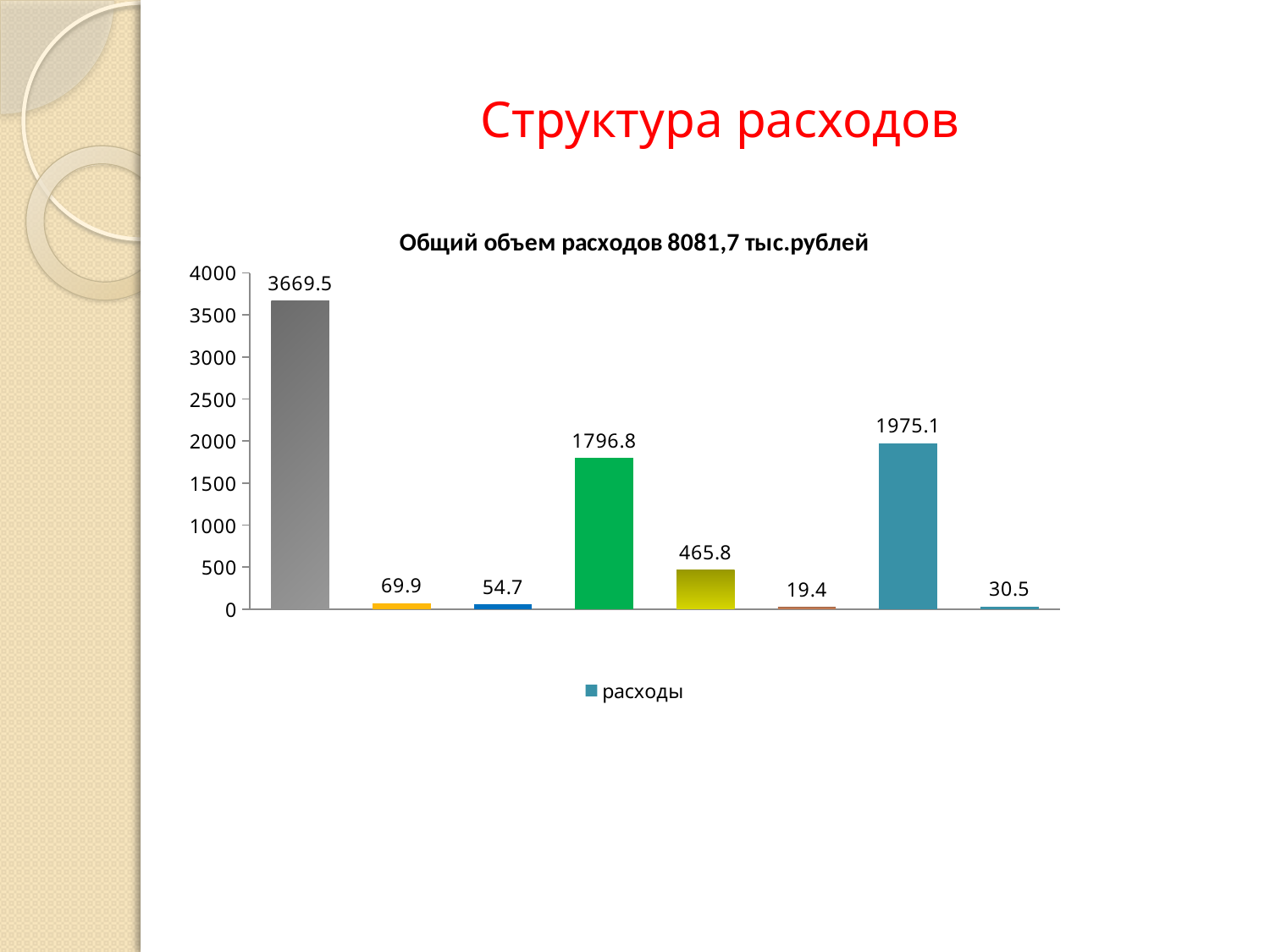
Which is larger, the green bar (1796.8) or the teal bar (1975.1)? the teal bar (1975.1) What is the lowest value shown in the chart? 19.4 How many bars are plotted in the chart? 8 What type of chart is shown on the slide? bar chart What is the title of the chart? Общий объем расходов 8081,7 тыс.рублей What is the highest value shown in the chart? 3669.5 What is the difference between the first bar (3669.5) and the seventh bar (1975.1)? 1694.4 What is the value of the teal bar (seventh from the left)? 1975.1 What is the name of the series shown in the legend? расходы What is the value of the first (grey) bar on the left? 3669.5 What is the value of the green bar (fourth from the left)? 1796.8 How many series does the legend list? 1